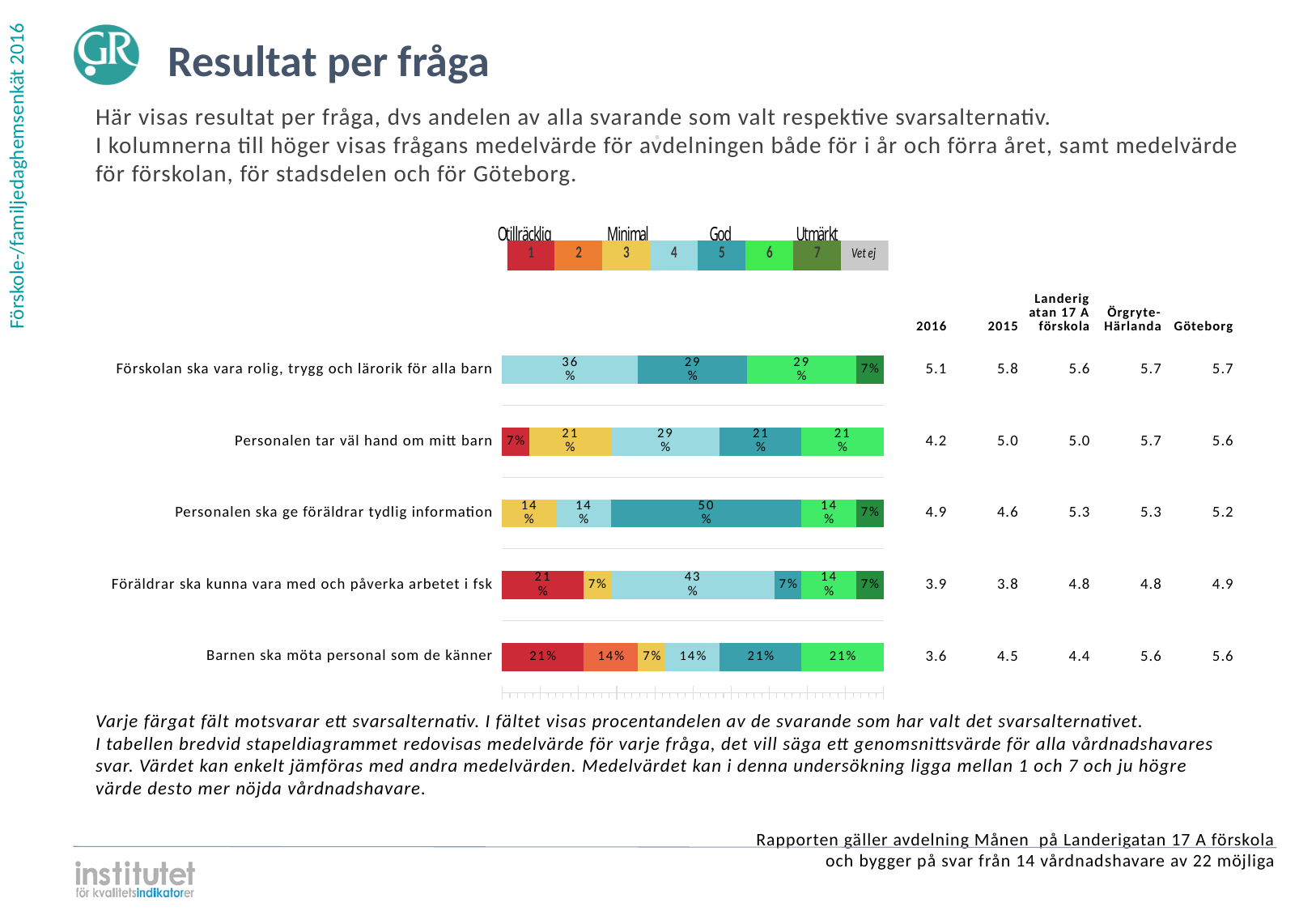
Which question has the highest 2016 mean value in the table next to the chart? Förskolan ska vara rolig, trygg och lärorik för alla barn What kind of chart is used to show the share of respondents choosing each answer alternative? Stacked bar chart Which question has the largest single segment in its bar? Personalen ska ge föräldrar tydlig information For 'Föräldrar ska kunna vara med och påverka arbetet i fsk', what is the difference between the alternative 4 share (43%) and the alternative 1 share (21%)? 22 percentage points What is the title of the slide containing the chart? Resultat per fråga What percentage of respondents chose alternative 5 (teal) for 'Personalen ska ge föräldrar tydlig information'? 50% How many answer alternatives does the legend above the chart list, including 'Vet ej'? 8 For 'Personalen tar väl hand om mitt barn', which is larger: the share for alternative 4 (light blue) or the share for alternative 1 (red)? Alternative 4 (29%) What percentage of respondents chose alternative 4 (light blue) for 'Förskolan ska vara rolig, trygg och lärorik för alla barn'? 36% How many questions (categories) are plotted in the bar chart? 5 What is the 2016 mean value shown for 'Barnen ska möta personal som de känner'? 3.6 What percentage of respondents chose alternative 1 (red) for 'Barnen ska möta personal som de känner'? 21%